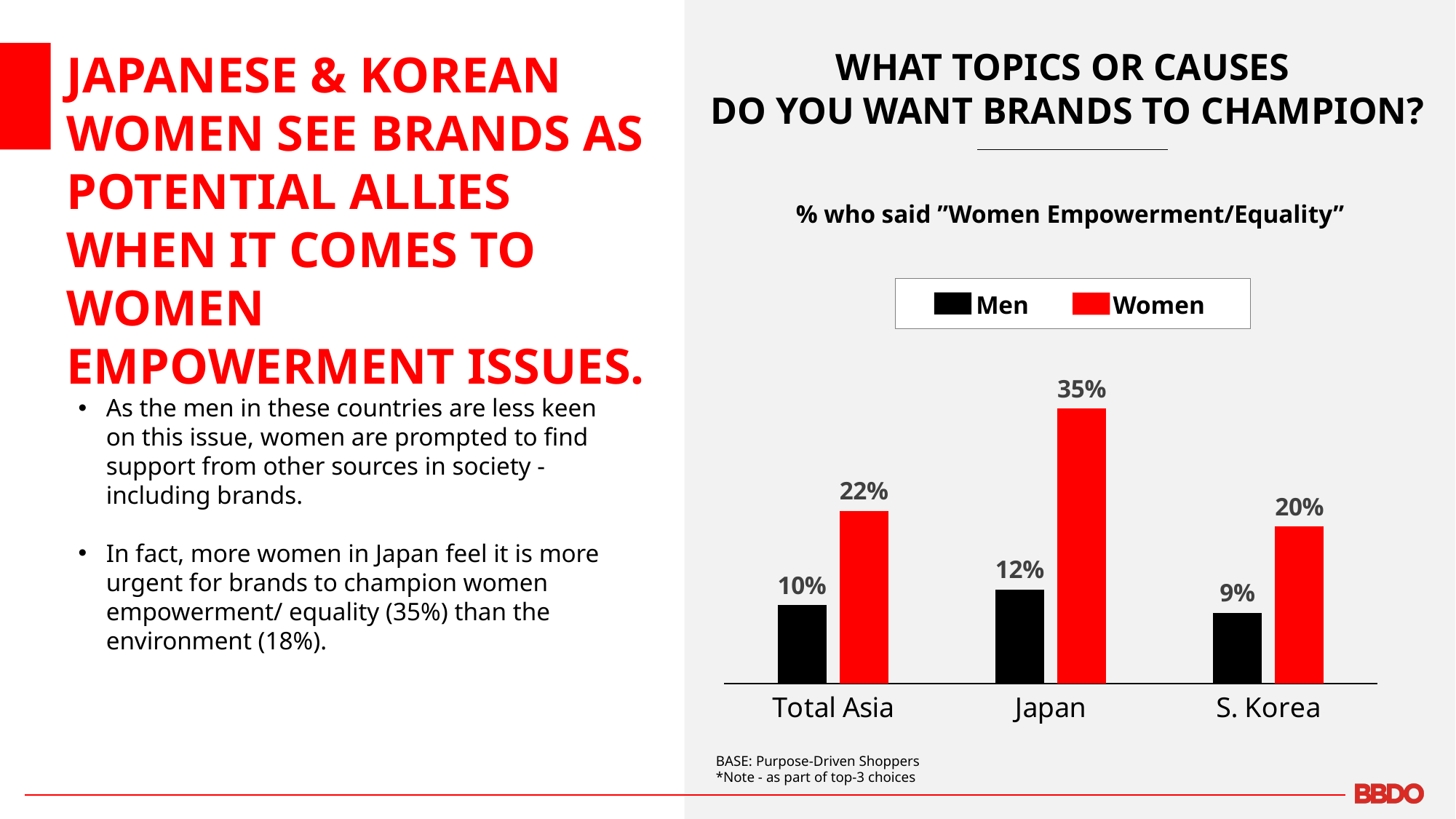
What kind of chart is shown on the slide? Bar chart Which category has the highest value for women? Japan Which category has the lowest value for men? S. Korea What is the difference between the women and men values for Japan? 23% What is the value for women in Total Asia? 22% What is the difference between the women values for Japan and S. Korea? 15% What percentage of women in Japan said "Women Empowerment/Equality"? 35% Which is larger: the value for women in S. Korea or the value for women in Total Asia? Women in Total Asia What is the value for men in Japan? 12% How many series does the legend list? 2 How many categories are shown on the x axis? 3 What percentage of men in S. Korea said "Women Empowerment/Equality"? 9%